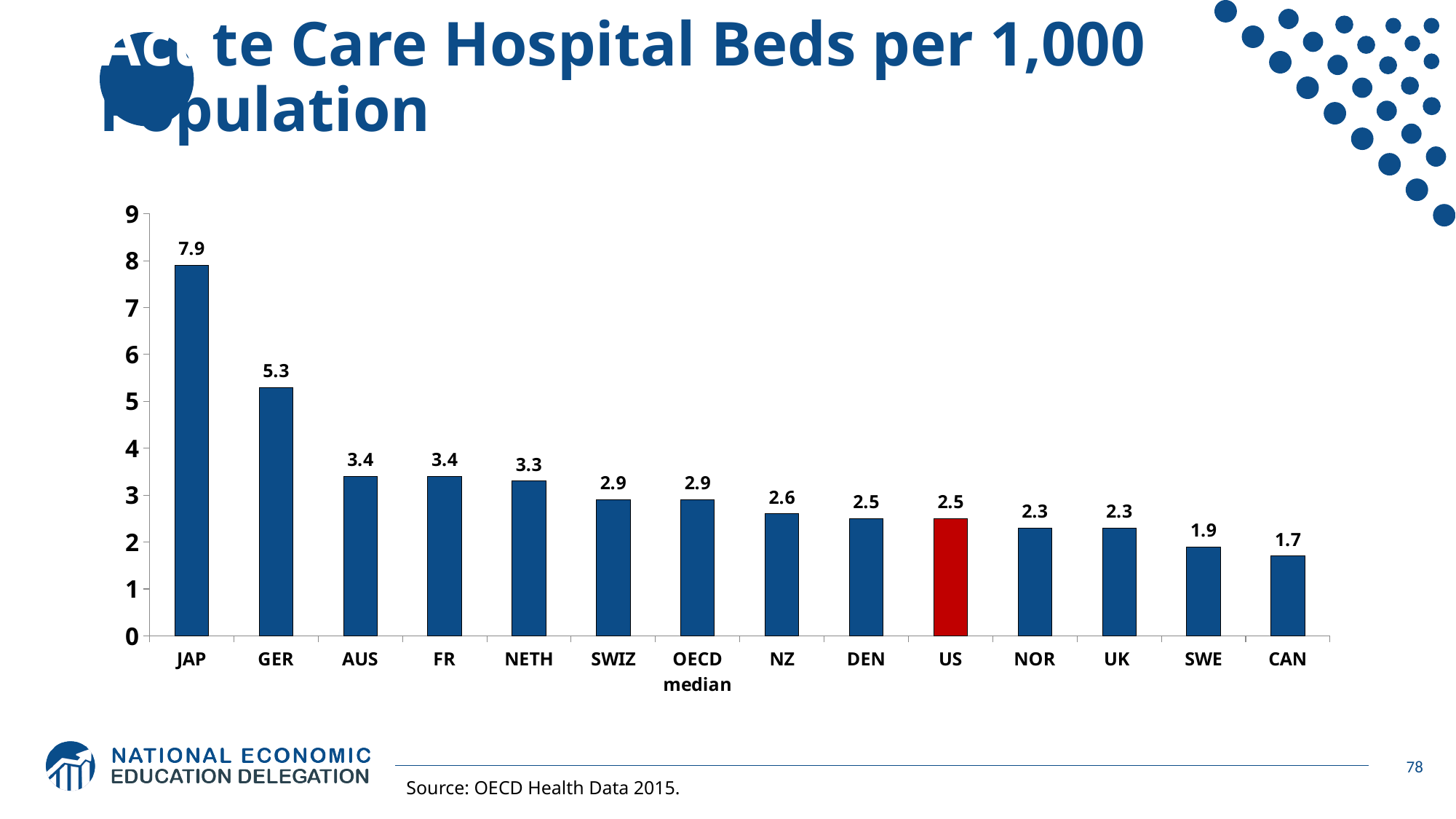
What is the difference between the values for JAP and GER? 2.6 Which country has the lowest number of acute care hospital beds per 1,000 population? CAN Which bar is coloured red instead of blue? US What is the difference between the OECD median and the US value? 0.4 How many categories are shown on the x axis? 14 What is the value for the US? 2.5 Which country has the highest number of acute care hospital beds per 1,000 population? JAP Which is larger, the value for NETH or the value for SWIZ? NETH Is the value for GER greater or less than 5? greater What is the value for JAP? 7.9 What is the value for the OECD median? 2.9 What kind of chart is shown on the slide? Bar chart